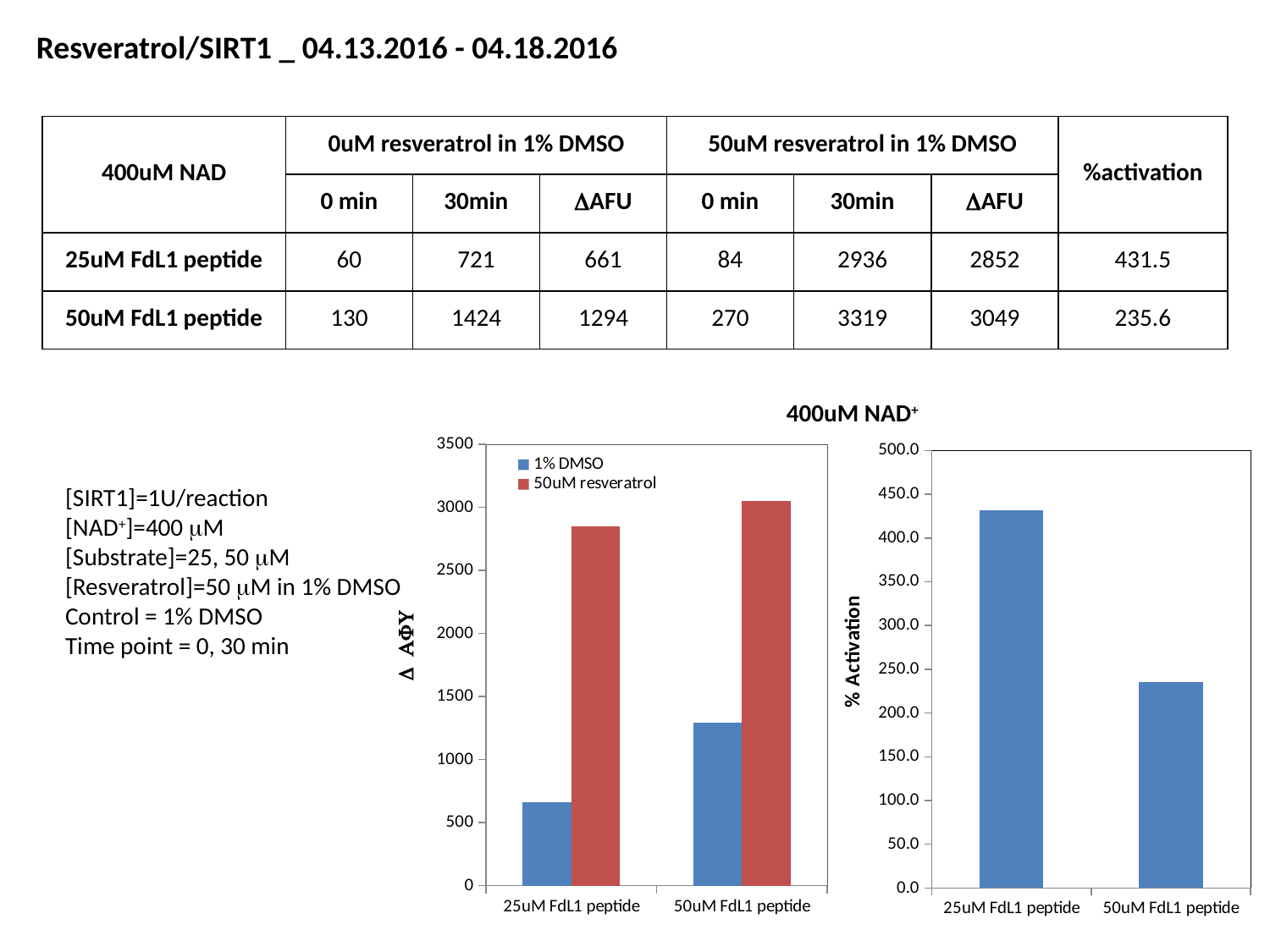
How many categories are shown on the x axis of the left chart? 2 In the left chart, for 25uM FdL1 peptide, which series has the larger value: 1% DMSO or 50uM resveratrol? 50uM resveratrol In the left chart, is the 1% DMSO value for 50uM FdL1 peptide greater or less than 1500? less In the right chart (400uM NAD+), is the value for 25uM FdL1 peptide greater or less than 400.0? greater In the right chart (400uM NAD+), is the value for 50uM FdL1 peptide greater or less than 250.0? less How many series does the legend of the left chart list? 2 What is the y-axis label of the right chart? % Activation What kind of chart is the left chart on the slide? bar chart In the right chart (400uM NAD+), which category has the highest % Activation? 25uM FdL1 peptide In the right chart (400uM NAD+), do the values rise or fall from left to right along the x axis? fall